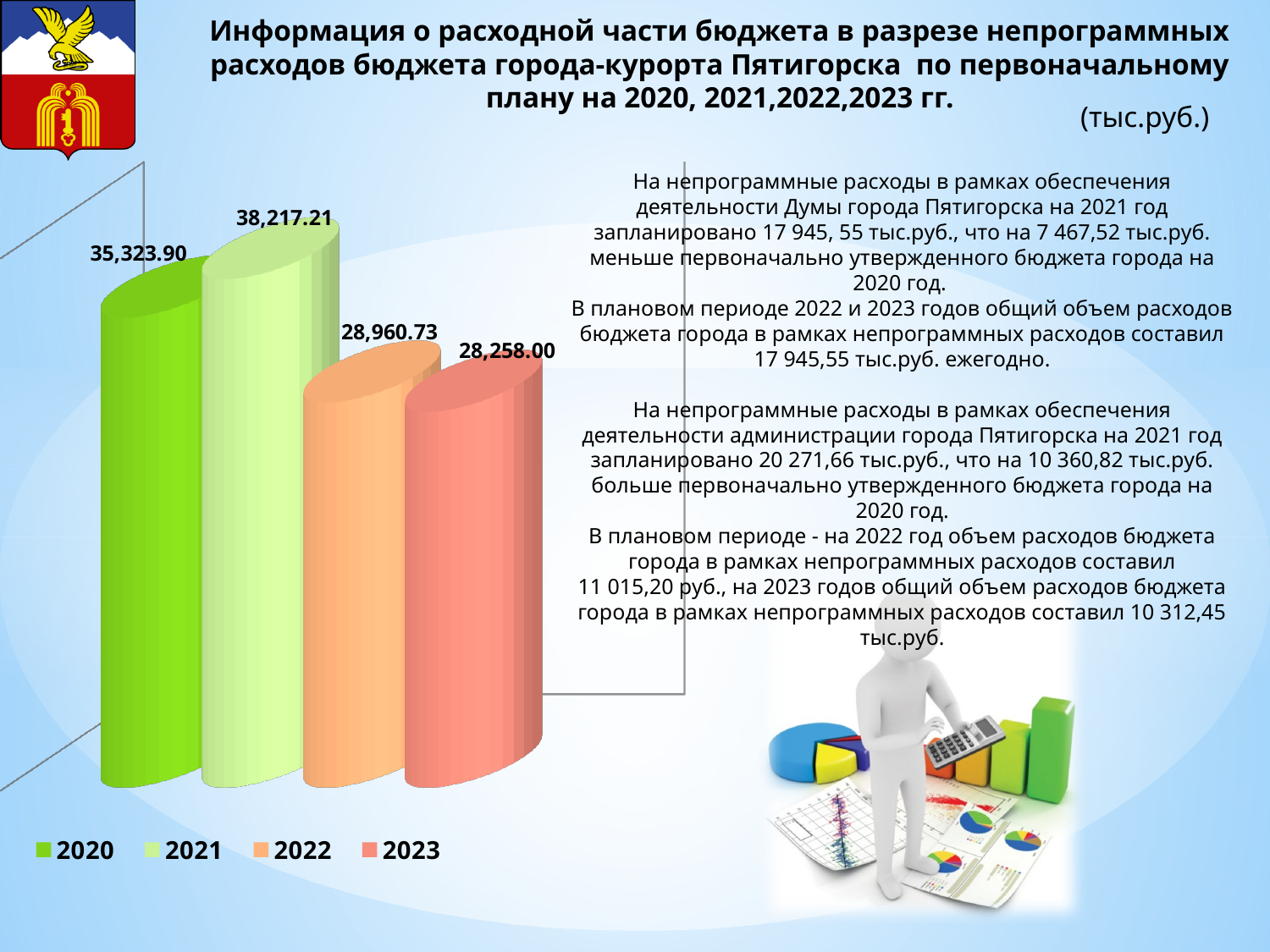
What is the difference between the values for 2021 and 2020? 2,893.31 What is the difference between the values for 2022 and 2023? 702.73 What is the value shown for 2022? 28,960.73 Which year has the highest value in the chart? 2021 Which is larger, the value for 2020 or the value for 2022? 2020 Which year has the lowest value in the chart? 2023 Do the values rise or fall from 2021 to 2023? Fall What kind of chart is shown on the slide? Bar chart What is the value shown for 2021? 38,217.21 What is the value shown for 2023? 28,258.00 What is the value shown for 2020? 35,323.90 How many series does the legend list? 4